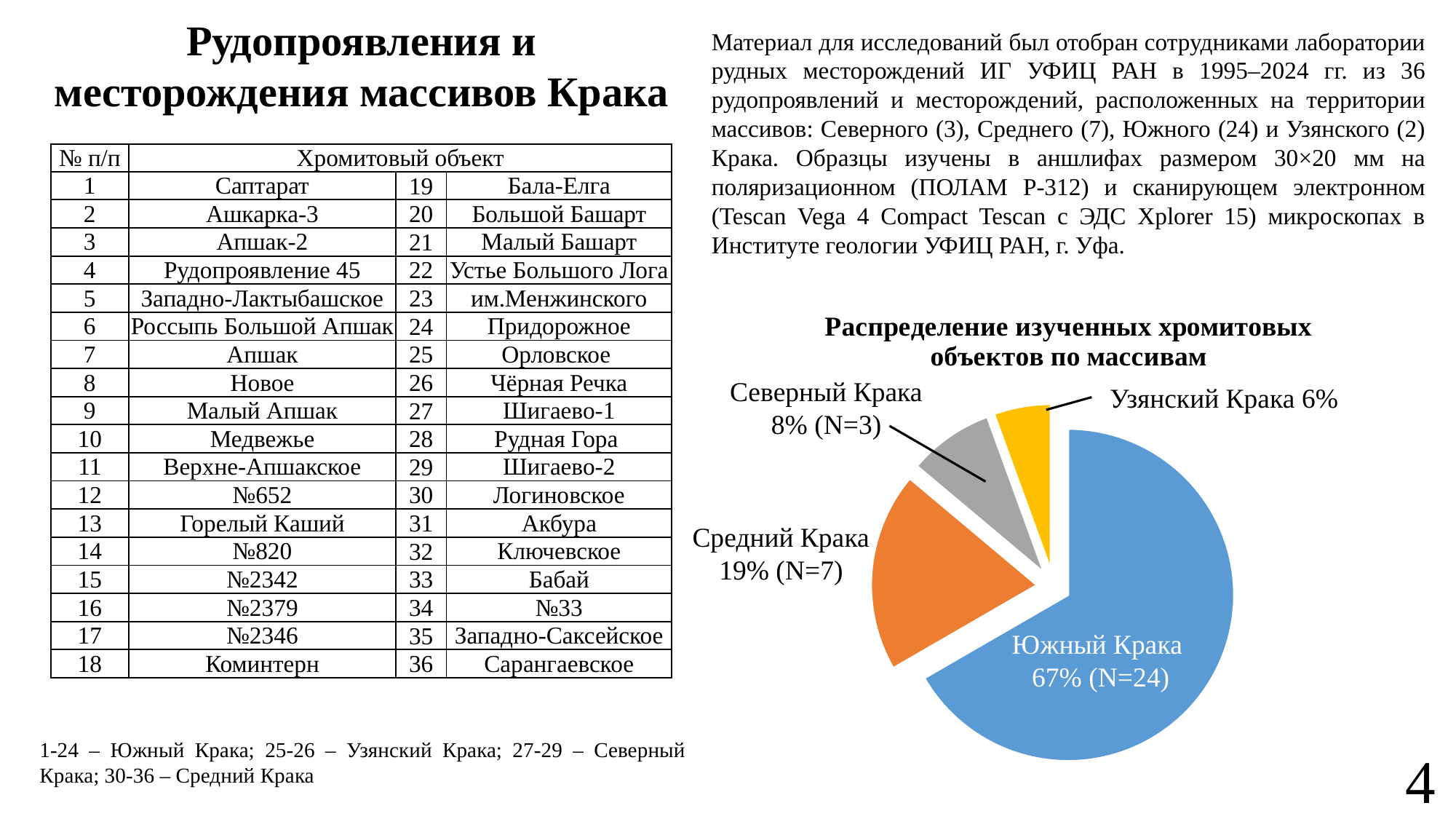
Which massif has the largest slice of the pie? Южный Крака How many slices does the pie chart have? 4 What kind of chart is shown on the slide? pie chart Which massif has the smallest slice of the pie? Узянский Крака What is the difference in percentage share between Южный Крака and Средний Крака? 48% How many objects (N) are shown for Средний Крака? N=7 How many objects (N) are shown for Северный Крака? N=3 What is the title of the pie chart? Распределение изученных хромитовых объектов по массивам What share of the pie does Средний Крака have? 19% What share of the pie does Узянский Крака have? 6% What share of the pie does Северный Крака have? 8%